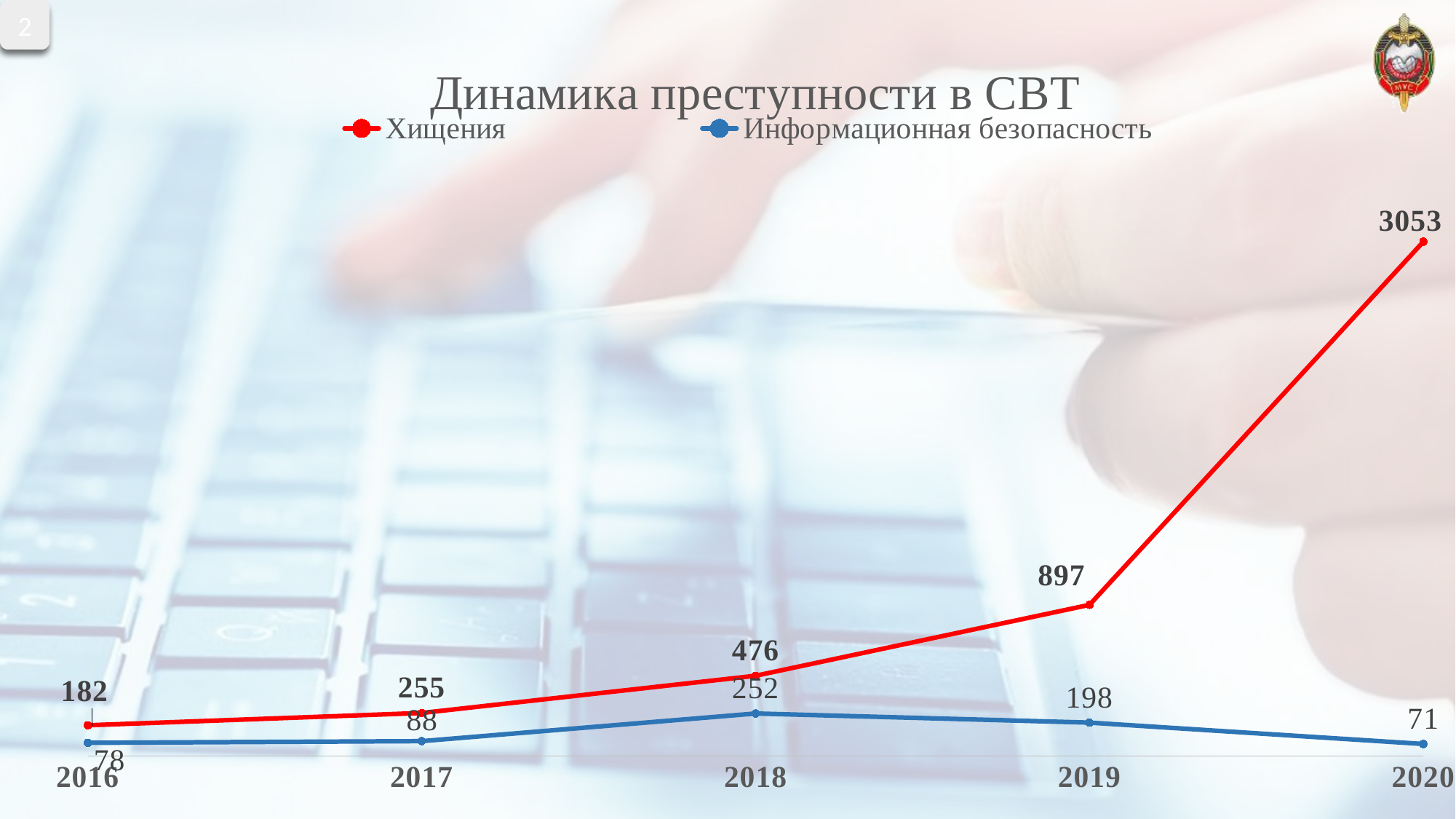
What is the value for Хищения in 2017? 255 Does the value for Хищения rise or fall from 2016 to 2020? rise What is the value for Информационная безопасность in 2016? 78 How many series does the legend list? 2 In which year is the value for Информационная безопасность lowest? 2020 How many years are shown on the x axis? 5 What is the value for Хищения in 2020? 3053 What is the difference between Хищения in 2020 and Хищения in 2019? 2156 What kind of chart is shown on the slide? line chart In which year is the value for Хищения highest? 2020 What is the value for Информационная безопасность in 2018? 252 Which is larger in 2019: Хищения or Информационная безопасность? Хищения